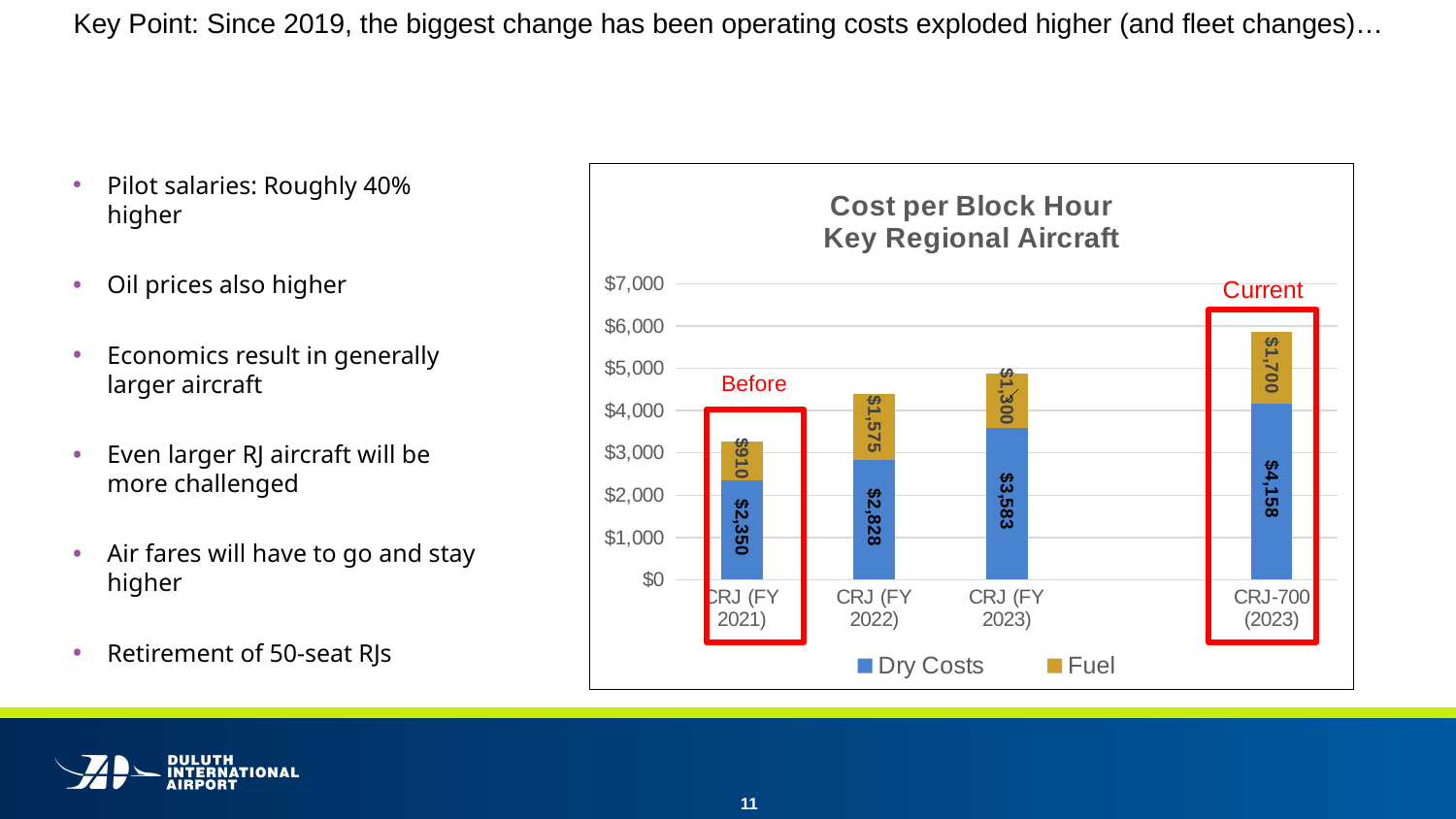
What kind of chart is shown? Stacked bar chart What is the Dry Costs value for CRJ (FY 2021)? $2,350 What is the Dry Costs value for CRJ (FY 2023)? $3,583 Which category has the lowest Fuel value? CRJ (FY 2021) Which category has the highest Dry Costs value? CRJ-700 (2023) How many categories are shown on the x axis? 4 Which is larger, the Fuel value for CRJ (FY 2022) or for CRJ (FY 2023)? CRJ (FY 2022) What is the difference in Dry Costs between CRJ-700 (2023) and CRJ (FY 2021)? $1,808 How many series does the legend list? 2 What is the Fuel value for CRJ-700 (2023)? $1,700 What is the Fuel value for CRJ (FY 2022)? $1,575 What is the total stacked value for CRJ-700 (2023)? $5,858